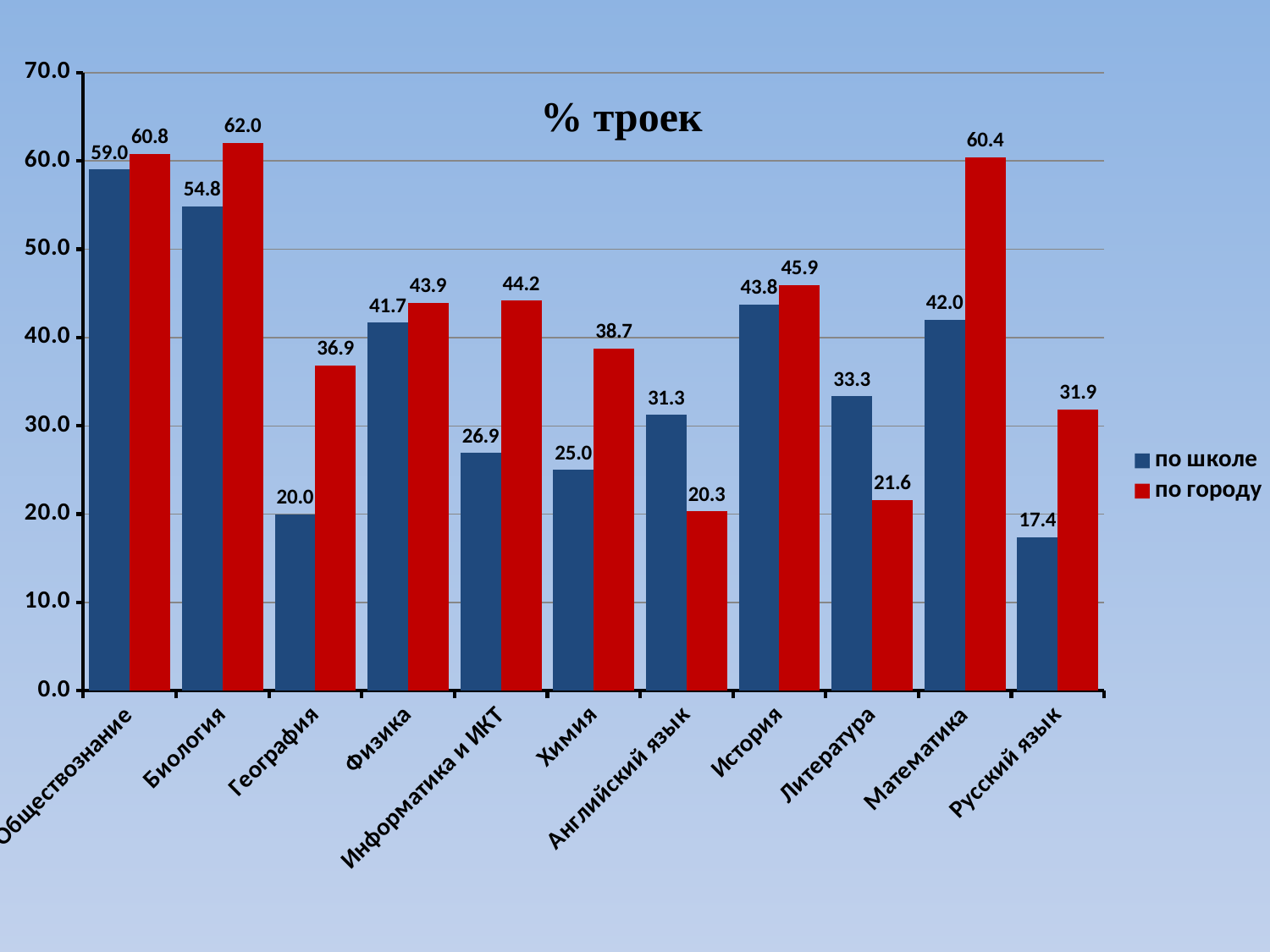
What is the difference between the по городу and по школе values for География? 16.9 Which is larger for Литература: the по школе value or the по городу value? по школе What is the value for Русский язык in the по школе series? 17.4 Is the по городу value for Химия greater or less than 30.0? greater How many categories are shown on the x axis? 11 What is the value for Математика in the по городу series? 60.4 What is the value for Информатика и ИКТ in the по городу series? 44.2 What is the title of the chart? % троек What kind of chart is shown on the slide? bar chart Which category has the highest value in the по школе series? Обществознание How many series does the legend list? 2 Which category has the lowest value in the по городу series? Английский язык